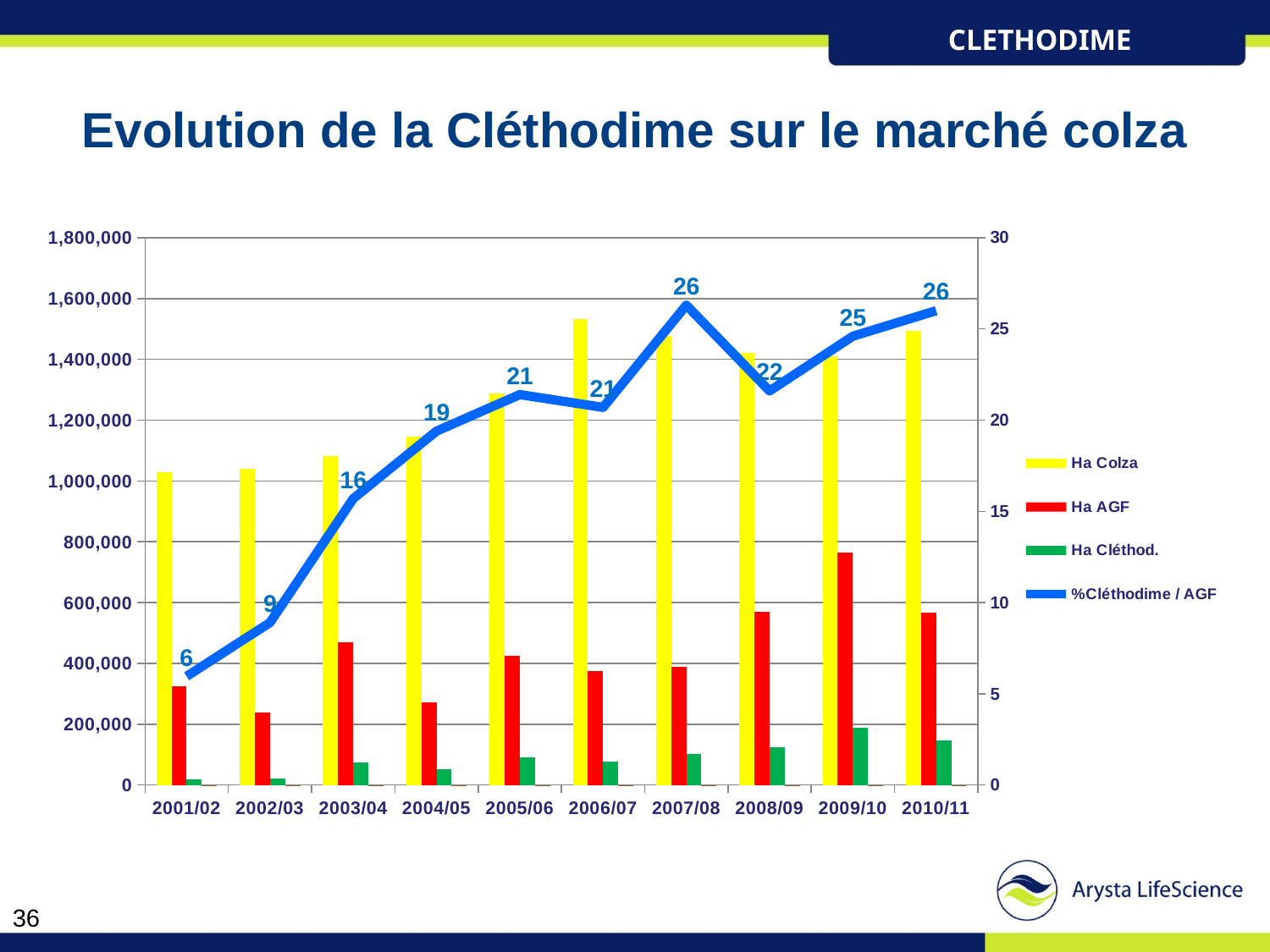
Is the Ha Colza value for 2007/08 greater or less than 1,400,000? greater In which season is the Ha AGF bar the highest? 2009/10 Is the Ha AGF value for 2002/03 greater or less than 400,000? less In which season is the %Cléthodime / AGF value lowest? 2001/02 By how much does the %Cléthodime / AGF value in 2010/11 exceed the value in 2001/02? 20 How many series does the legend list? 4 What is the %Cléthodime / AGF value for 2001/02? 6 What is the %Cléthodime / AGF value for 2007/08? 26 Which season has a higher %Cléthodime / AGF value, 2008/09 or 2009/10? 2009/10 What is the %Cléthodime / AGF value for 2003/04? 16 In which season is the Ha Colza bar the highest? 2006/07 How many seasons are shown on the x axis? 10